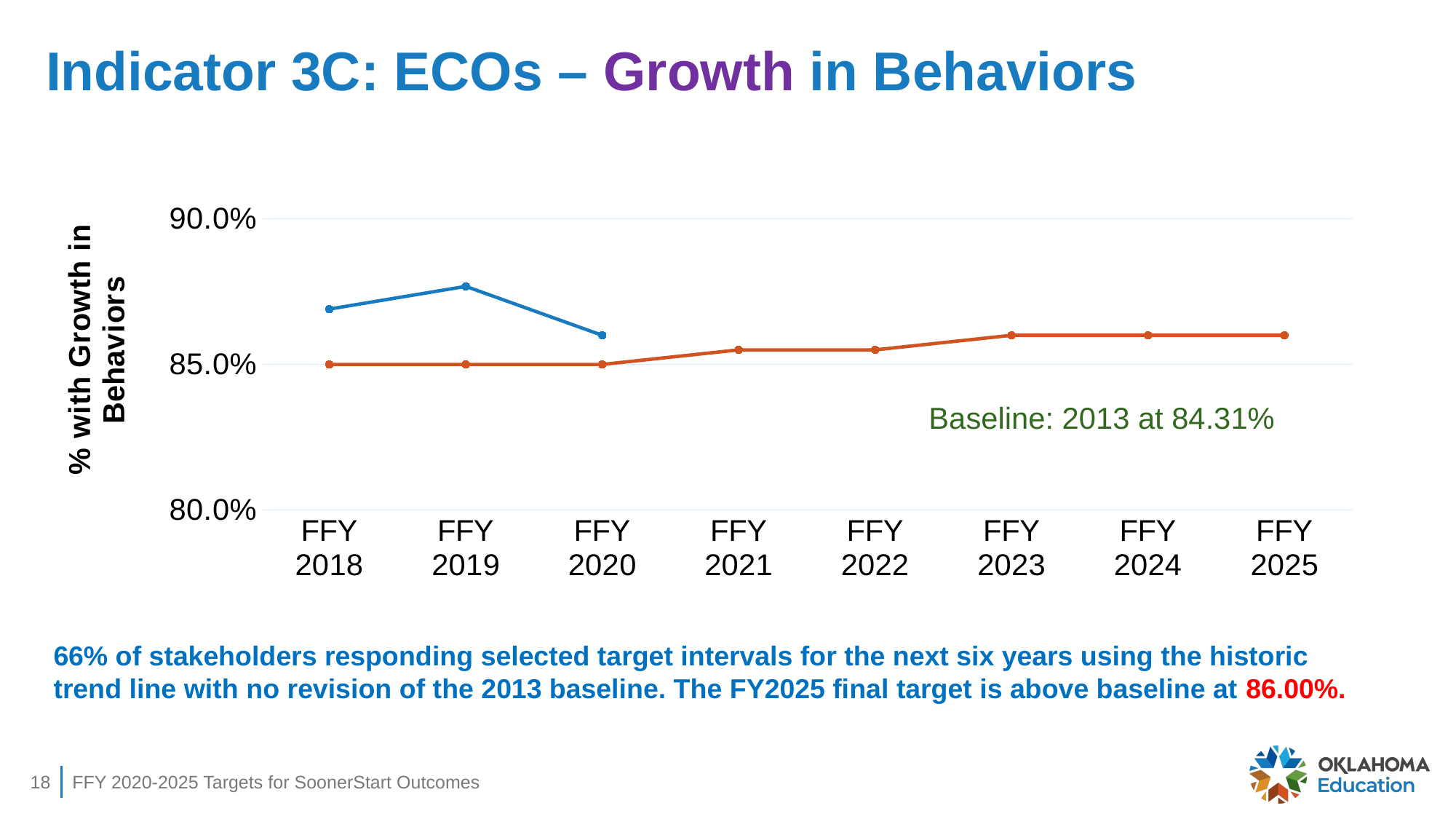
What is the FY2025 final target value stated on the slide? 86.00% What is the value of the orange line at FFY 2020? 85.0% Does the orange line rise or fall from FFY 2020 to FFY 2023? rise What is the value of the orange line at FFY 2018? 85.0% How many FFY categories are shown on the x axis? 8 Is the value of the blue line at FFY 2018 greater or less than 90.0%? less At which FFY does the blue line reach its lowest value? FFY 2020 At which FFY does the blue line reach its highest value? FFY 2019 What kind of chart is shown on the slide? line chart At FFY 2018, which line has the higher value, the blue line or the orange line? the blue line Is the value of the blue line at FFY 2019 greater or less than 85.0%? greater How many data points does the blue line have? 3